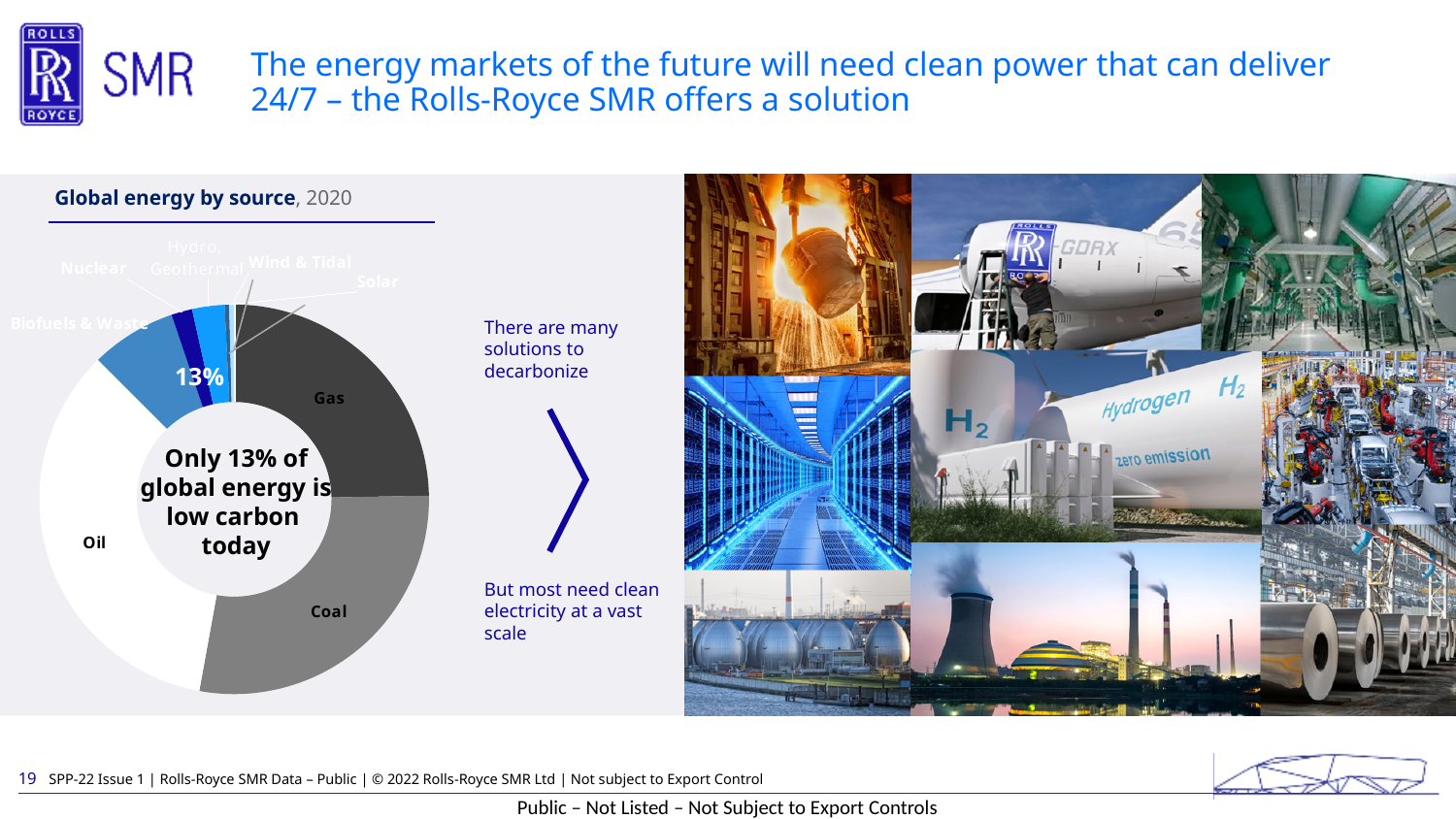
What is the title of the chart? Global energy by source, 2020 Which three energy sources make up the large non-low-carbon portion of the chart? Gas, Coal, Oil What year does the chart's data refer to? 2020 Which is larger in the chart, the Coal slice or the Solar slice? Coal Which is larger in the chart, the Oil slice or the Wind & Tidal slice? Oil Which is larger in the chart, the Biofuels & Waste slice or the Solar slice? Biofuels & Waste What kind of chart is shown on the slide? Pie chart (donut) What is the combined share of the low-carbon sources (Nuclear, Hydro/Geothermal, Wind & Tidal, Solar, Biofuels & Waste) in the chart? 13% What percentage of global energy is low carbon according to the chart? 13%